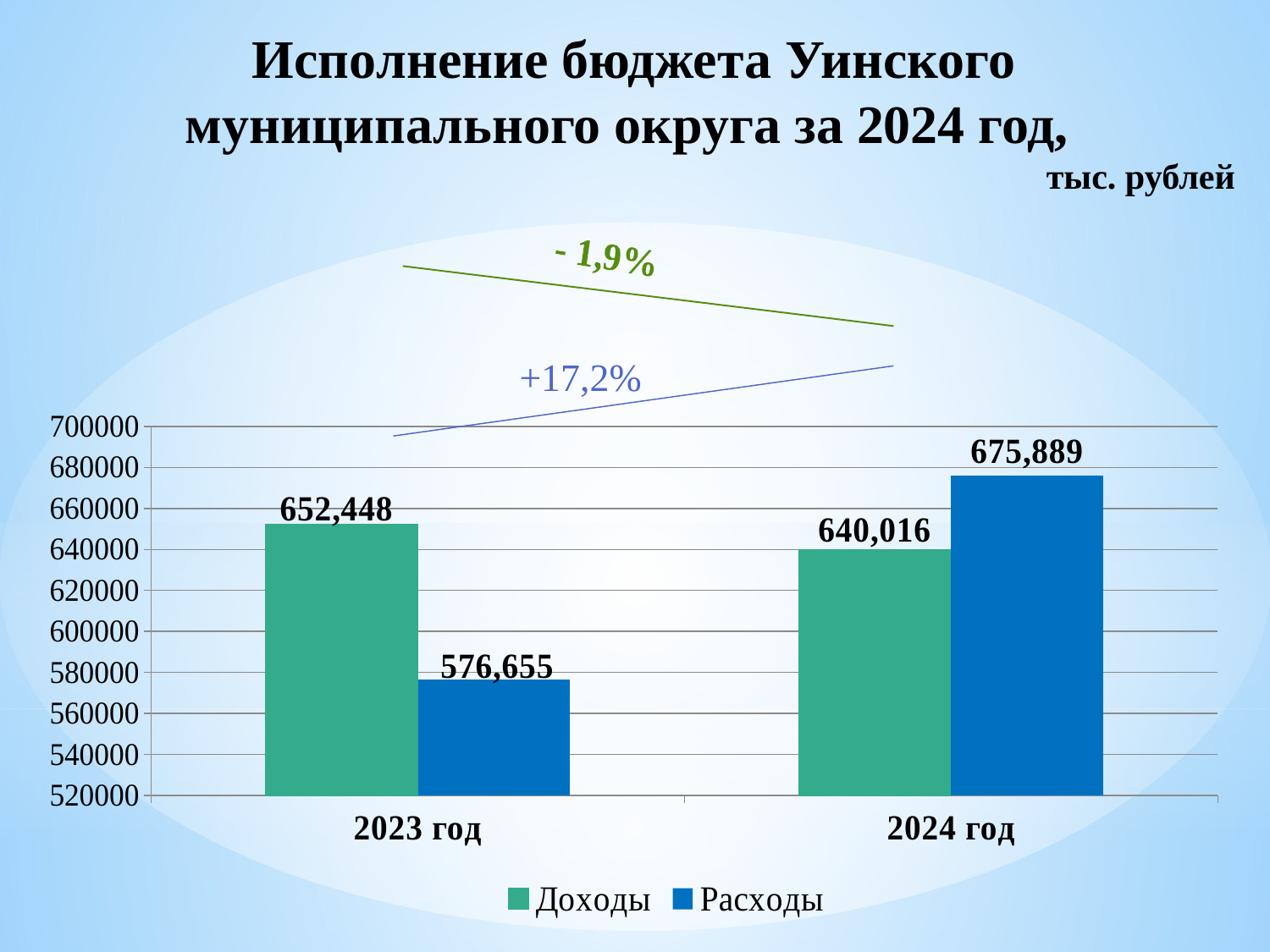
What is the value for Расходы in 2024 год? 675,889 What is the difference between Доходы and Расходы in 2023 год? 75,793 Which bar has the lowest value on the chart? Расходы in 2023 год Which bar has the highest value on the chart? Расходы in 2024 год What kind of chart is shown on the slide? Bar chart How many series does the legend list? 2 What is the value for Доходы in 2024 год? 640,016 Do the values for Доходы rise or fall from 2023 год to 2024 год? Fall What is the value for Доходы in 2023 год? 652,448 Which is larger in 2024 год, Доходы or Расходы? Расходы What is the difference between Расходы and Доходы in 2024 год? 35,873 What is the value for Расходы in 2023 год? 576,655